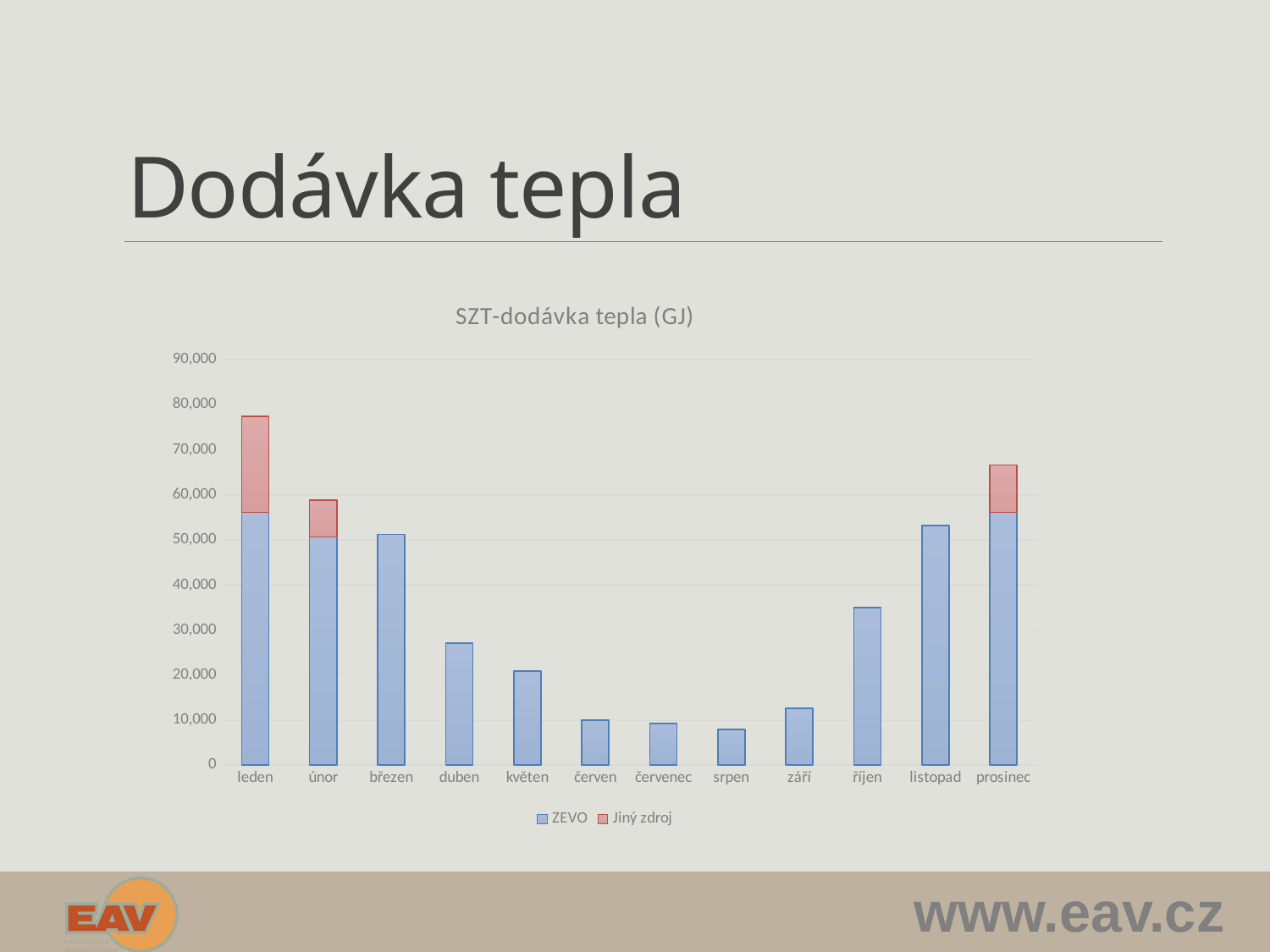
Is the value for říjen greater or less than 30,000? greater Which has the larger total bar, leden or prosinec? leden Is the total value for leden greater or less than 70,000? greater Which months have a visible 'Jiný zdroj' (red) segment in the chart? leden, únor, prosinec Do the bar values rise or fall from leden to srpen? fall Is the total value for prosinec greater or less than 60,000? greater What is the title of the chart? SZT-dodávka tepla (GJ) How many months (categories) are shown on the x axis of the chart? 12 Which month has the highest total bar in the chart? leden What kind of chart is shown on the slide? Stacked bar chart How many series does the chart legend list? 2